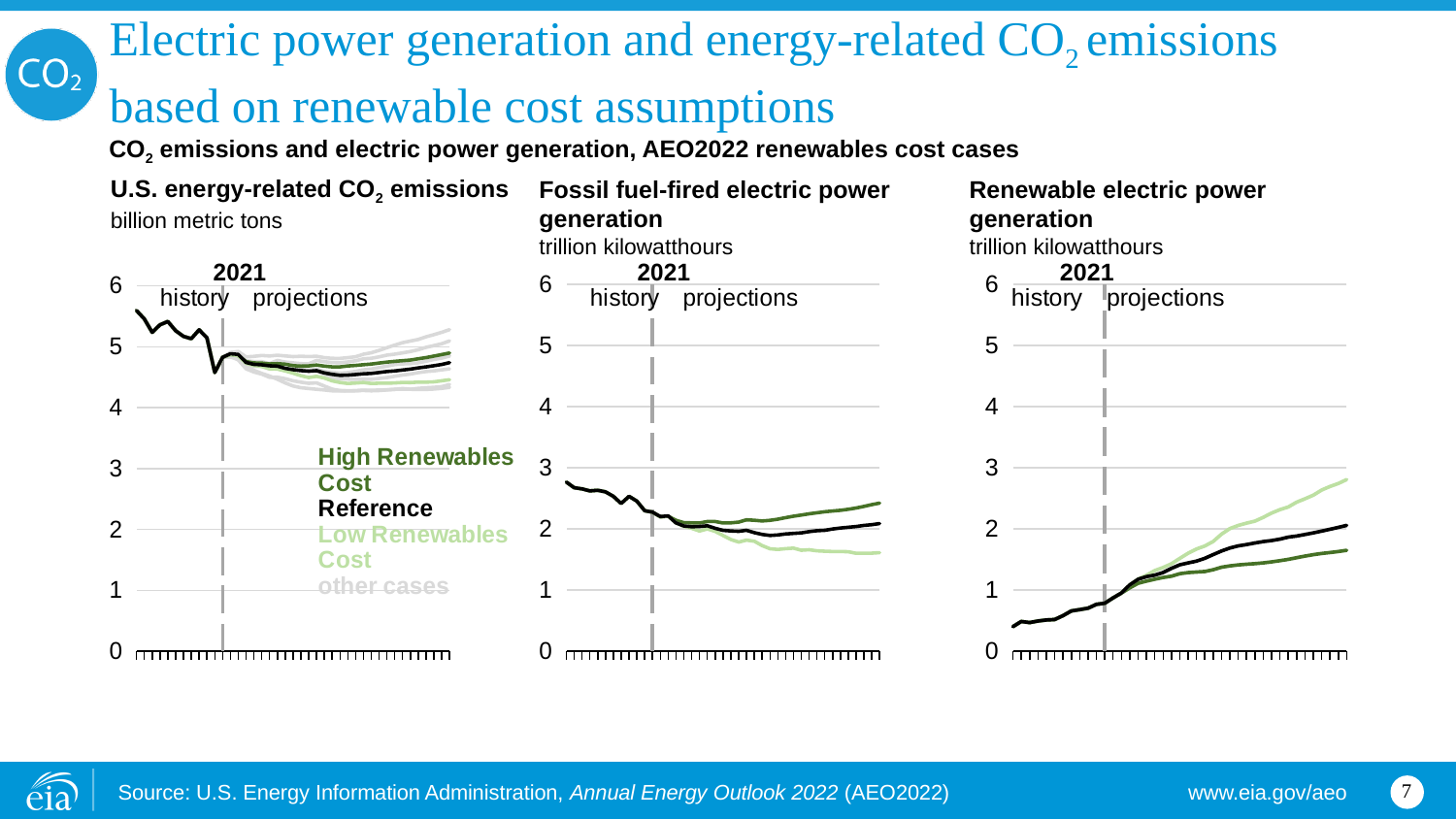
In the 'Renewable electric power generation' chart, is the value at the start of the history period greater or less than 1? less In the 'Fossil fuel-fired electric power generation' chart, which case is higher at the end of the projection period: High Renewables Cost or Low Renewables Cost? High Renewables Cost In the 'Renewable electric power generation' chart, do the values generally rise or fall along the x axis? rise In the 'Fossil fuel-fired electric power generation' chart, is the Low Renewables Cost value at the end of the projection period greater or less than 2? less Which year does the dashed vertical line separating history from projections mark in each chart? 2021 In the 'Renewable electric power generation' chart, is the Low Renewables Cost value at the end of the projection period greater or less than 2? greater What unit is used on the 'Renewable electric power generation' chart? trillion kilowatthours What kind of chart is the 'U.S. energy-related CO2 emissions' chart? line chart How many entries does the legend on the slide list? 4 In the 'Renewable electric power generation' chart, which case is higher at the end of the projection period: High Renewables Cost or Low Renewables Cost? Low Renewables Cost In the 'Fossil fuel-fired electric power generation' chart, do the values generally rise or fall from the start of history to the end of the projections? fall